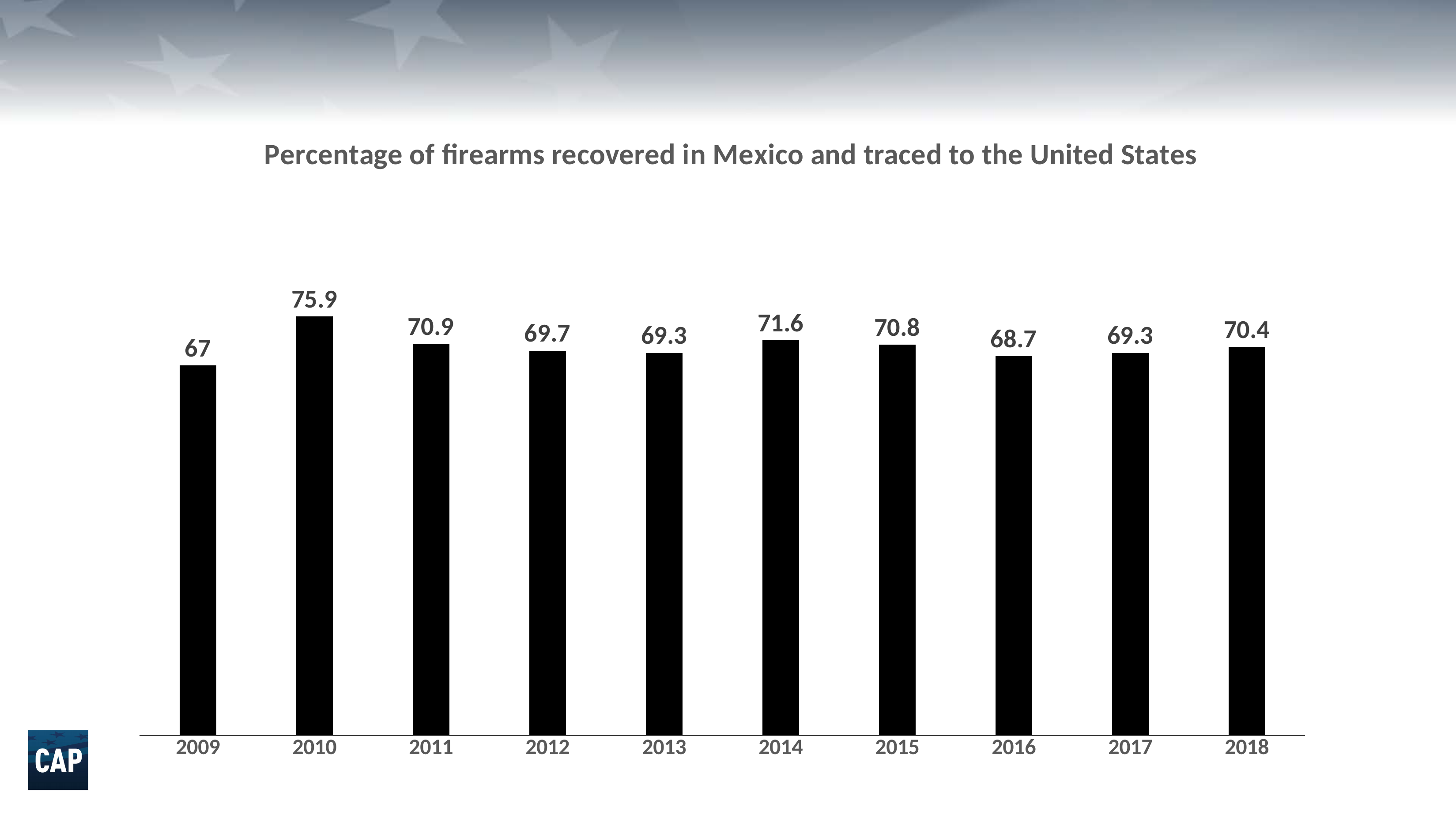
What kind of chart is this? bar chart What is the difference between the values for 2010 and 2009? 8.9 What is the difference between the values for 2014 and 2016? 2.9 Which year has the highest value? 2010 Which is larger, the value for 2014 or the value for 2013? 2014 What is the value for 2010? 75.9 Which year has the lowest value? 2009 What is the title of the chart? Percentage of firearms recovered in Mexico and traced to the United States What is the value for 2009? 67 What is the value for 2016? 68.7 What is the value for 2018? 70.4 How many years are shown on the chart? 10